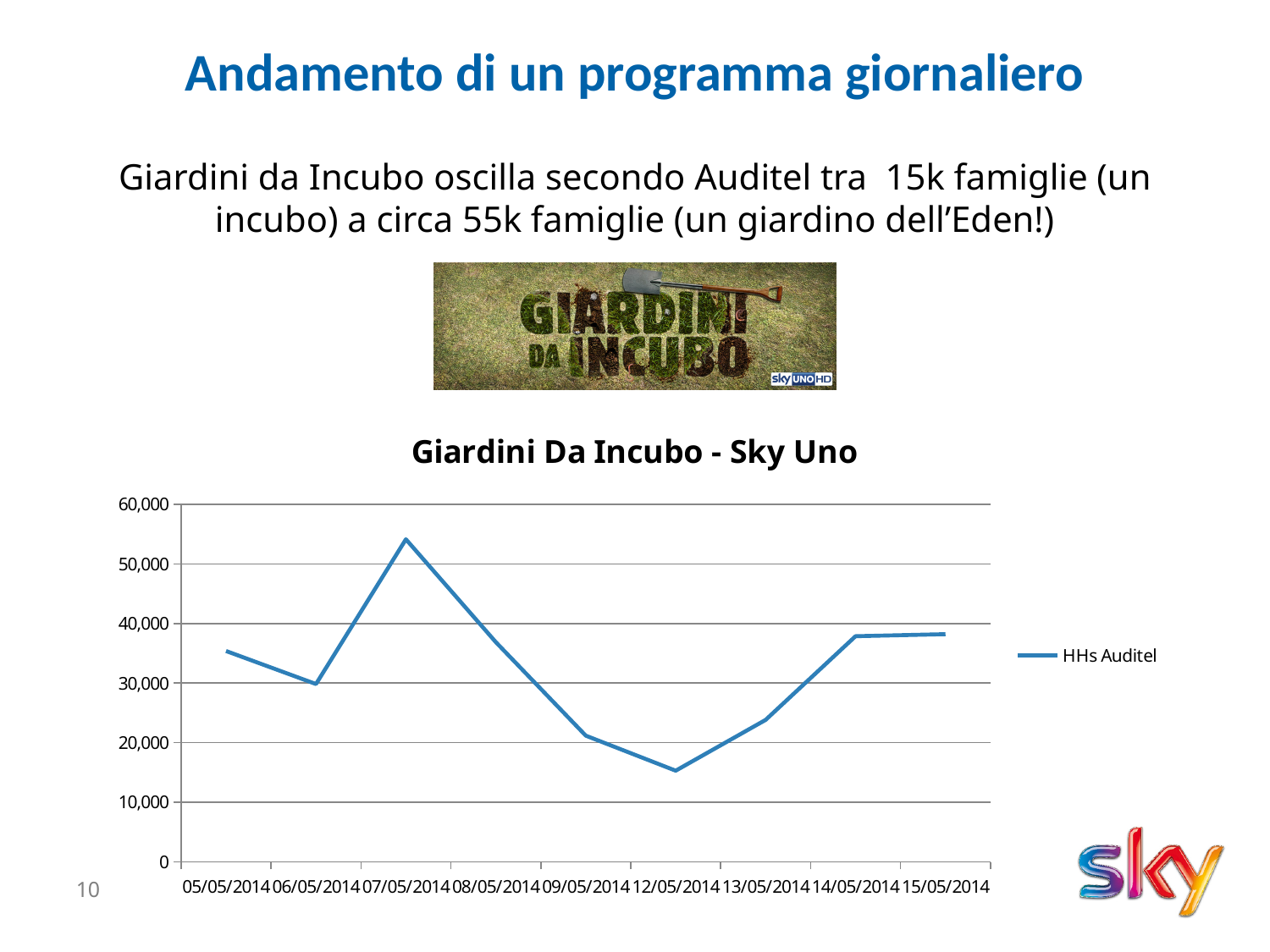
What kind of chart is shown on the slide? line chart Is the value for 12/05/2014 greater or less than 20,000? less What is the name of the series shown in the legend? HHs Auditel Do the values rise or fall from 07/05/2014 to 12/05/2014? fall Is the value for 05/05/2014 greater or less than 30,000? greater Is the value for 07/05/2014 greater or less than 50,000? greater On which date is the HHs Auditel value highest? 07/05/2014 On which date is the HHs Auditel value lowest? 12/05/2014 Which date has the larger value, 06/05/2014 or 09/05/2014? 06/05/2014 How many dates are plotted along the x axis? 9 What is the title of the chart? Giardini Da Incubo - Sky Uno How many series does the legend list? 1